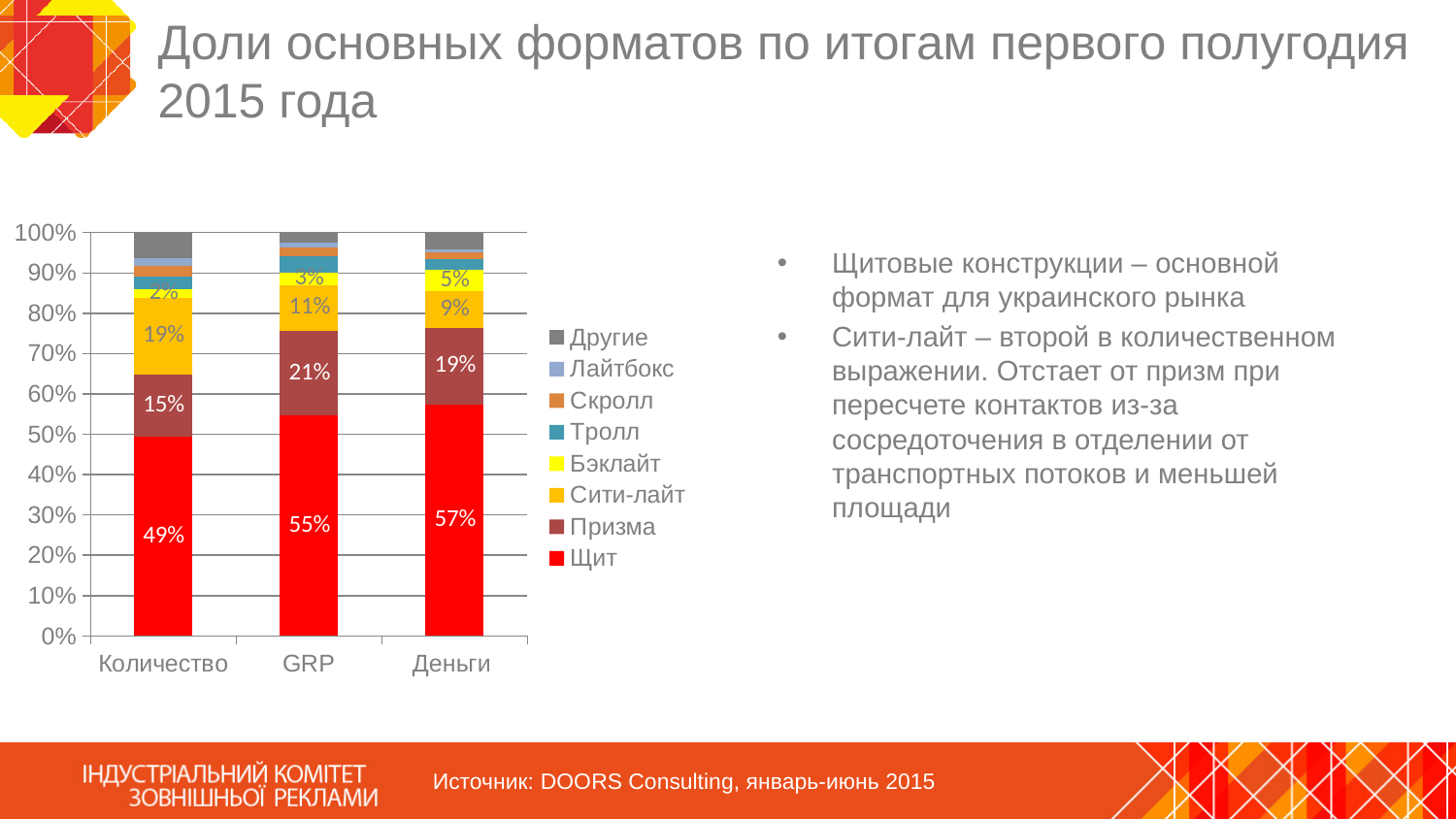
Which is larger for the GRP category: Призма or Сити-лайт? Призма What is the value of Сити-лайт for the Количество category? 19% What is the value of Щит for the Количество category? 49% What is the value of Призма for the GRP category? 21% How many series does the chart legend list? 8 What is the difference between the Щит values for Деньги and Количество? 8% What kind of chart is shown on the slide? stacked bar chart What is the value of Щит for the Деньги category? 57% In which category does Сити-лайт have its lowest value? Деньги How many categories are shown on the x axis of the chart? 3 In which category does Щит have its highest value? Деньги What is the value of Бэклайт for the Деньги category? 5%